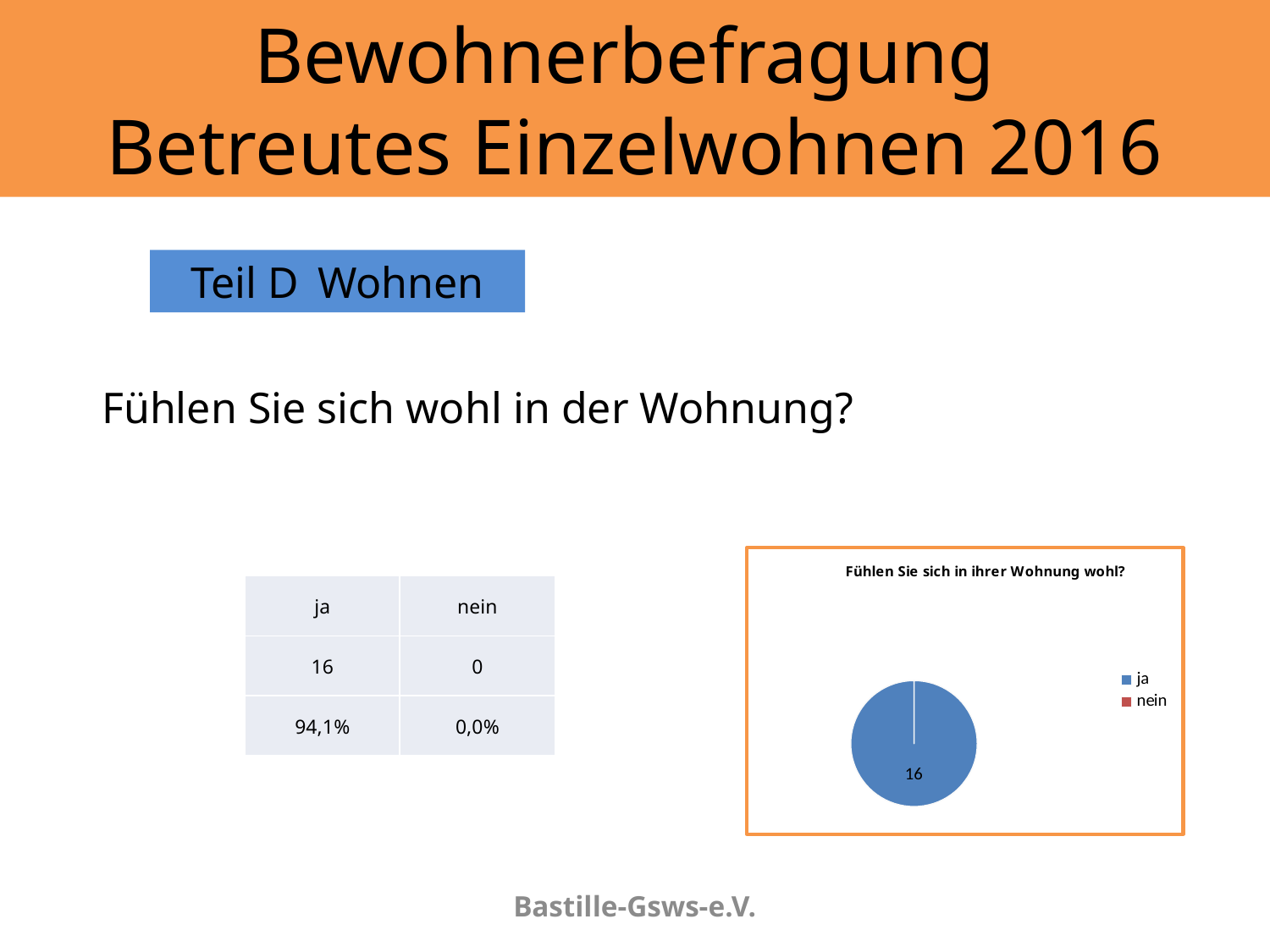
Which category has the largest slice in the pie chart? ja Is the value for 'ja' in the pie chart greater or less than 10? greater How many entries does the legend of the pie chart list? 2 In the pie chart, which is larger, 'ja' or 'nein'? ja What is the title of the pie chart? Fühlen Sie sich in ihrer Wohnung wohl? Which category has the smallest slice in the pie chart? nein What kind of chart is shown on the slide? pie chart What value is printed on the 'ja' slice of the pie chart? 16 What colour is the 'ja' slice in the pie chart? blue